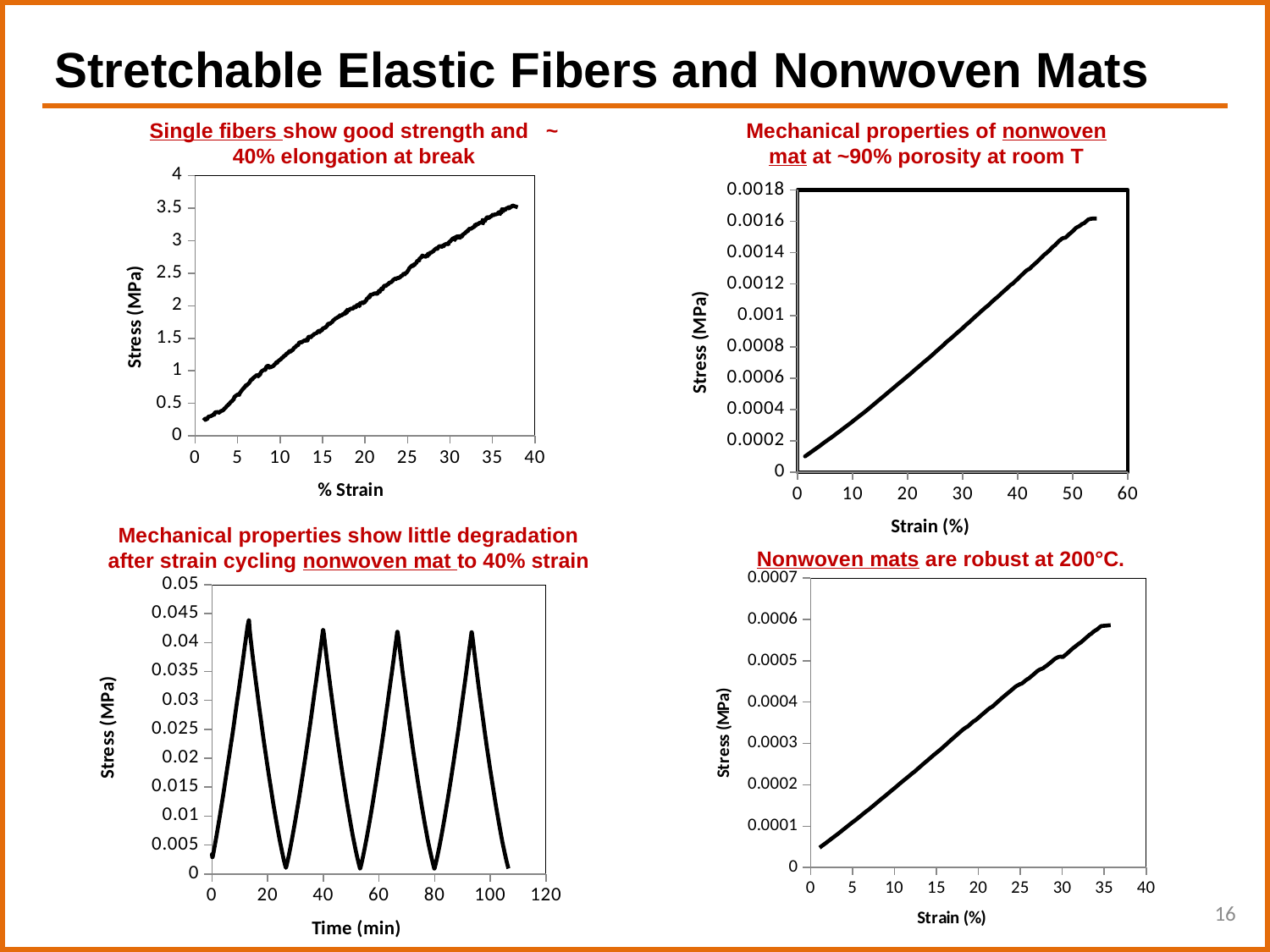
How many stress peaks (cycles) are shown in the bottom-left strain cycling chart? 4 In the top-right chart (nonwoven mat at ~90% porosity at room T), is the stress at 10% strain greater or less than 0.0004 MPa? less In the top-right chart (nonwoven mat at ~90% porosity at room T), is the stress at 40% strain greater or less than 0.001 MPa? greater What is the x-axis label of the top-left chart (single fibers)? % Strain In the top-right chart (nonwoven mat at ~90% porosity at room T), does stress rise or fall as strain increases? rise In the top-left chart (single fibers), is the stress at 35% strain greater or less than 3 MPa? greater In the bottom-right chart (nonwoven mats at 200°C), does stress rise or fall as strain increases? rise What is the x-axis label of the bottom-left strain cycling chart? Time (min) What kind of chart is the top-left chart titled 'Single fibers show good strength and ~40% elongation at break'? line chart In the top-left chart (single fibers), does stress rise or fall as % strain increases? rise